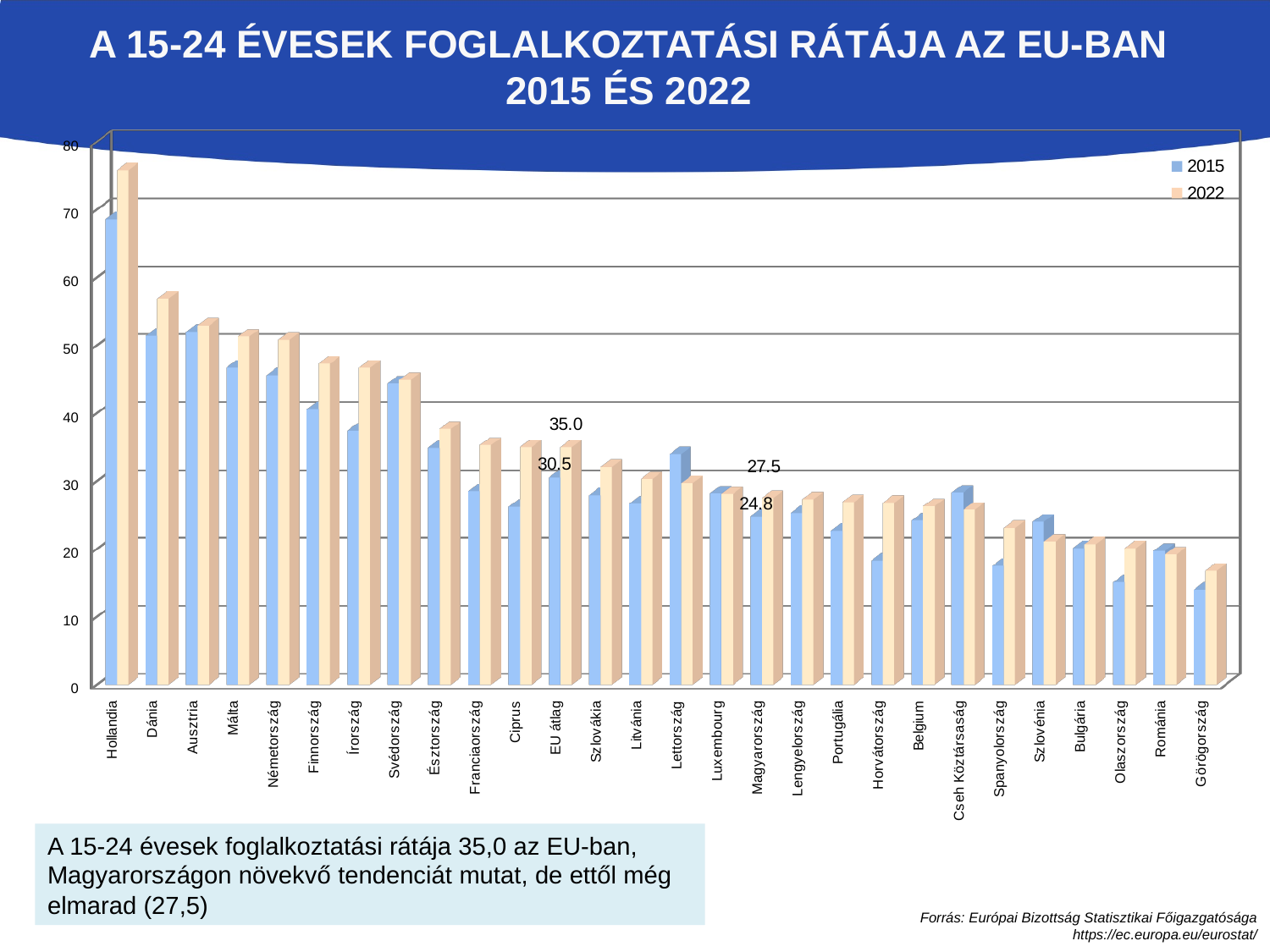
Is the 2022 value for Hollandia greater or less than 70? greater Which category has the highest 2022 value? Hollandia What is the 2015 value for Magyarország? 24.8 What is the 2022 value for Magyarország? 27.5 By how much did the EU átlag value increase from 2015 to 2022? 4.5 What is the difference between the 2022 values for EU átlag and Magyarország? 7.5 What is the 2022 value for EU átlag? 35.0 For Lettország, which is larger: the 2015 value or the 2022 value? 2015 What type of chart is shown on the slide? bar chart How many series does the legend list? 2 What is the 2015 value for EU átlag? 30.5 Which category has the lowest 2022 value? Görögország